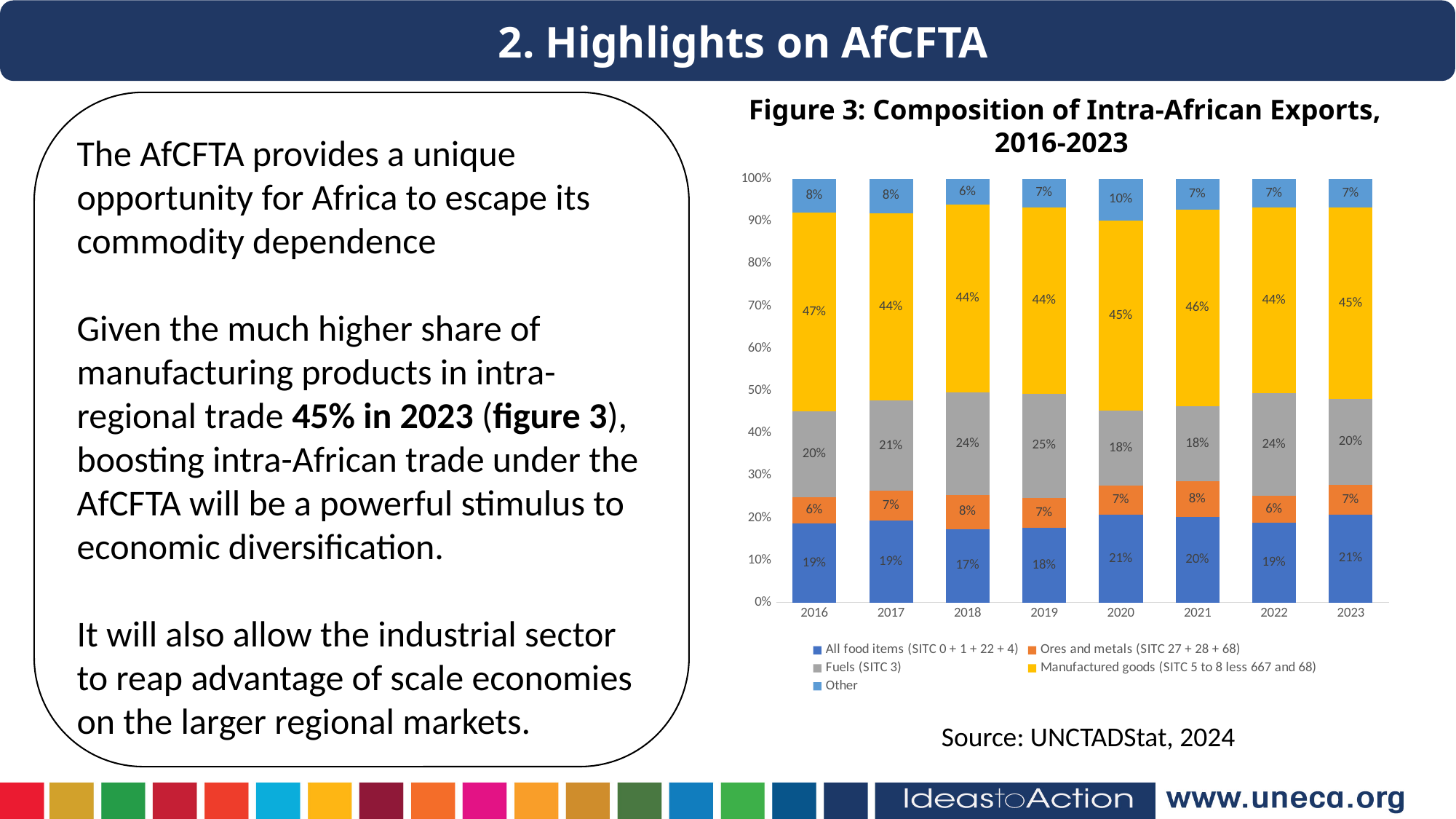
What share did 'Other' account for in 2020? 10% How many years are shown on the x axis of the chart? 8 In which year was the share of all food items lowest? 2018 Which colour represents manufactured goods in the chart? Yellow By how many percentage points did the share of fuels change from 2019 to 2020? 7 percentage points (25% to 18%) What was the share of fuels in intra-African exports in 2019? 25% How many series does the chart legend list? 5 Which was larger in 2021: the share of fuels or the share of all food items? All food items (20% vs 18%) What type of chart is Figure 3? Stacked bar chart In which year was the share of manufactured goods highest? 2016 What is the title of the chart? Figure 3: Composition of Intra-African Exports, 2016-2023 What share of intra-African exports did manufactured goods account for in 2023? 45%